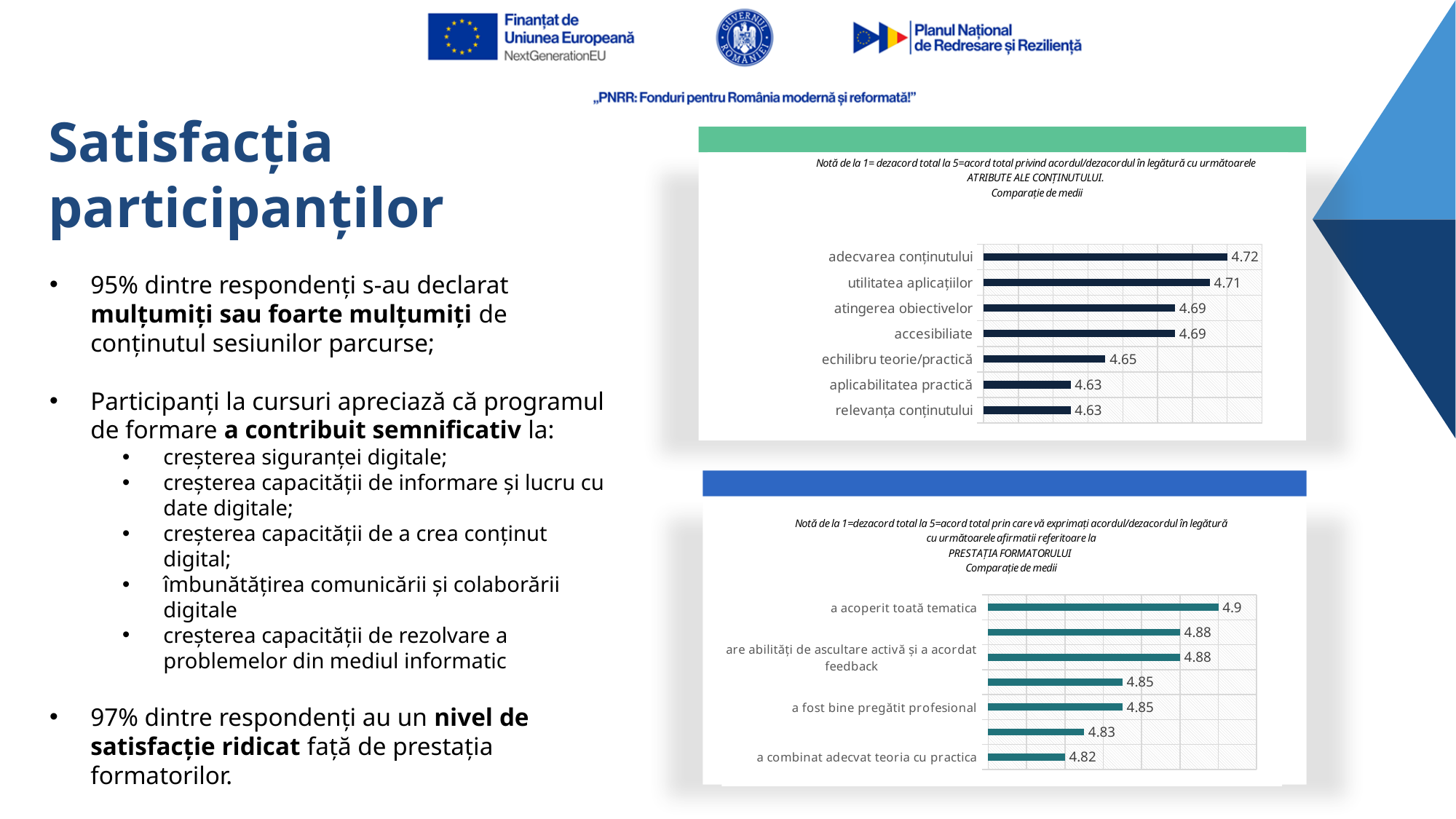
In the top chart (ATRIBUTE ALE CONȚINUTULUI), which category has the highest value? adecvarea conținutului In the bottom chart (PRESTAȚIA FORMATORULUI), how many bars are plotted? 7 In the bottom chart (PRESTAȚIA FORMATORULUI), what is the difference between the values for 'a acoperit toată tematica' and 'a combinat adecvat teoria cu practica'? 0.08 In the top chart (ATRIBUTE ALE CONȚINUTULUI), what is the value for 'adecvarea conținutului'? 4.72 In the bottom chart (PRESTAȚIA FORMATORULUI), what is the value for 'a acoperit toată tematica'? 4.9 In the top chart (ATRIBUTE ALE CONȚINUTULUI), what is the value for 'echilibru teorie/practică'? 4.65 In the top chart (ATRIBUTE ALE CONȚINUTULUI), how many categories are plotted? 7 What type of chart is the top chart (ATRIBUTE ALE CONȚINUTULUI)? bar chart In the top chart (ATRIBUTE ALE CONȚINUTULUI), which is larger: the value for 'utilitatea aplicațiilor' or the value for 'aplicabilitatea practică'? utilitatea aplicațiilor In the top chart (ATRIBUTE ALE CONȚINUTULUI), what is the difference between the values for 'adecvarea conținutului' and 'relevanța conținutului'? 0.09 In the bottom chart (PRESTAȚIA FORMATORULUI), what is the value for 'a fost bine pregătit profesional'? 4.85 In the bottom chart (PRESTAȚIA FORMATORULUI), what is the value for 'a combinat adecvat teoria cu practica'? 4.82